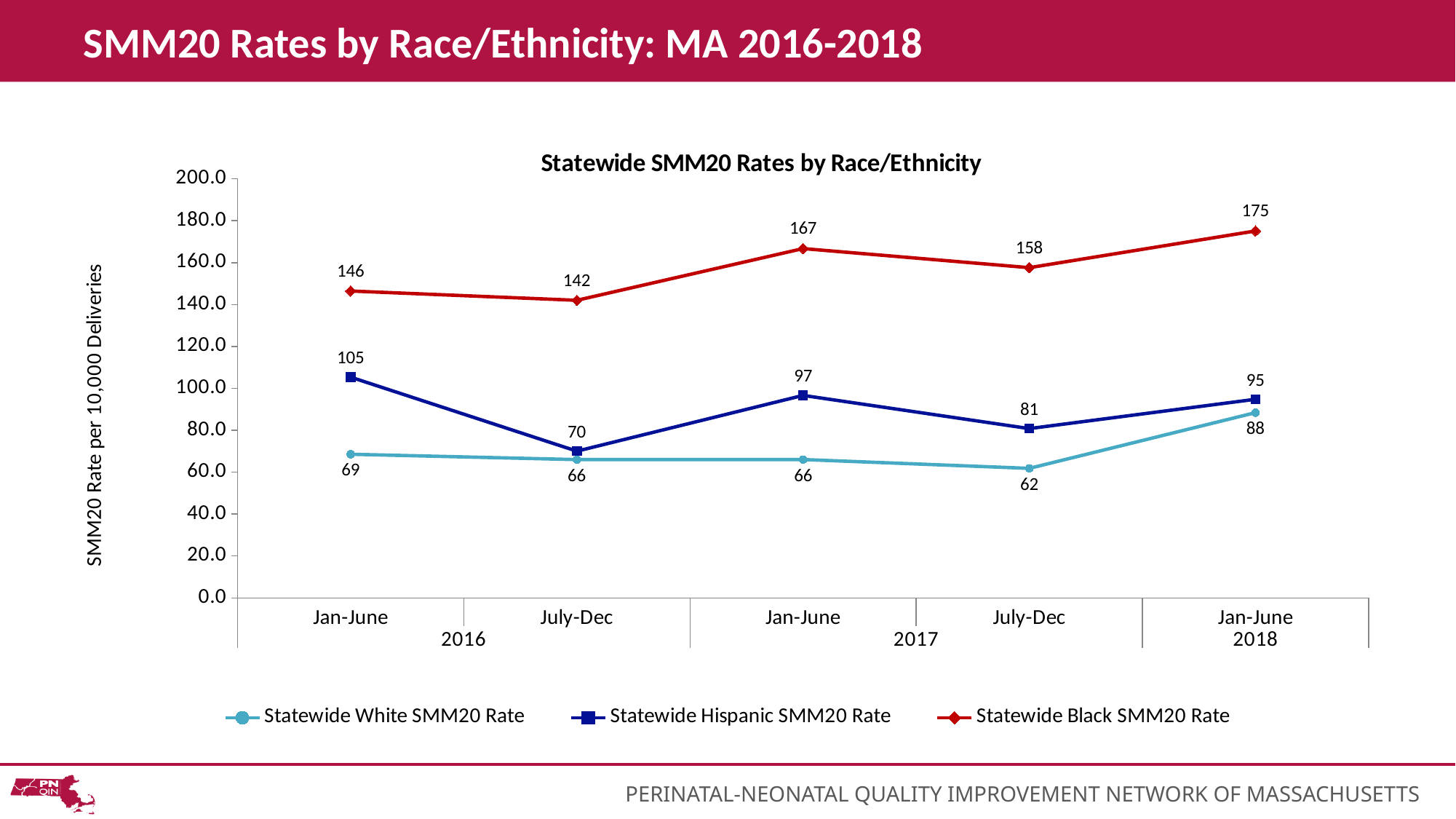
In which period is the Statewide Black SMM20 Rate highest? Jan-June 2018 What kind of chart is shown on the slide? Line chart What is the Statewide White SMM20 Rate for July-Dec 2017? 62 Is the Statewide Black SMM20 Rate for July-Dec 2016 greater or less than 120.0? greater What is the title of the chart? Statewide SMM20 Rates by Race/Ethnicity How many time periods are plotted on the x axis? 5 What is the difference between the Statewide Black SMM20 Rate and the Statewide White SMM20 Rate in Jan-June 2017? 101 How many series does the legend list? 3 What is the Statewide Black SMM20 Rate for Jan-June 2018? 175 In which period is the Statewide Hispanic SMM20 Rate lowest? July-Dec 2016 Which is larger in Jan-June 2018: the Statewide Hispanic SMM20 Rate or the Statewide White SMM20 Rate? Statewide Hispanic SMM20 Rate What is the Statewide Hispanic SMM20 Rate for July-Dec 2016? 70